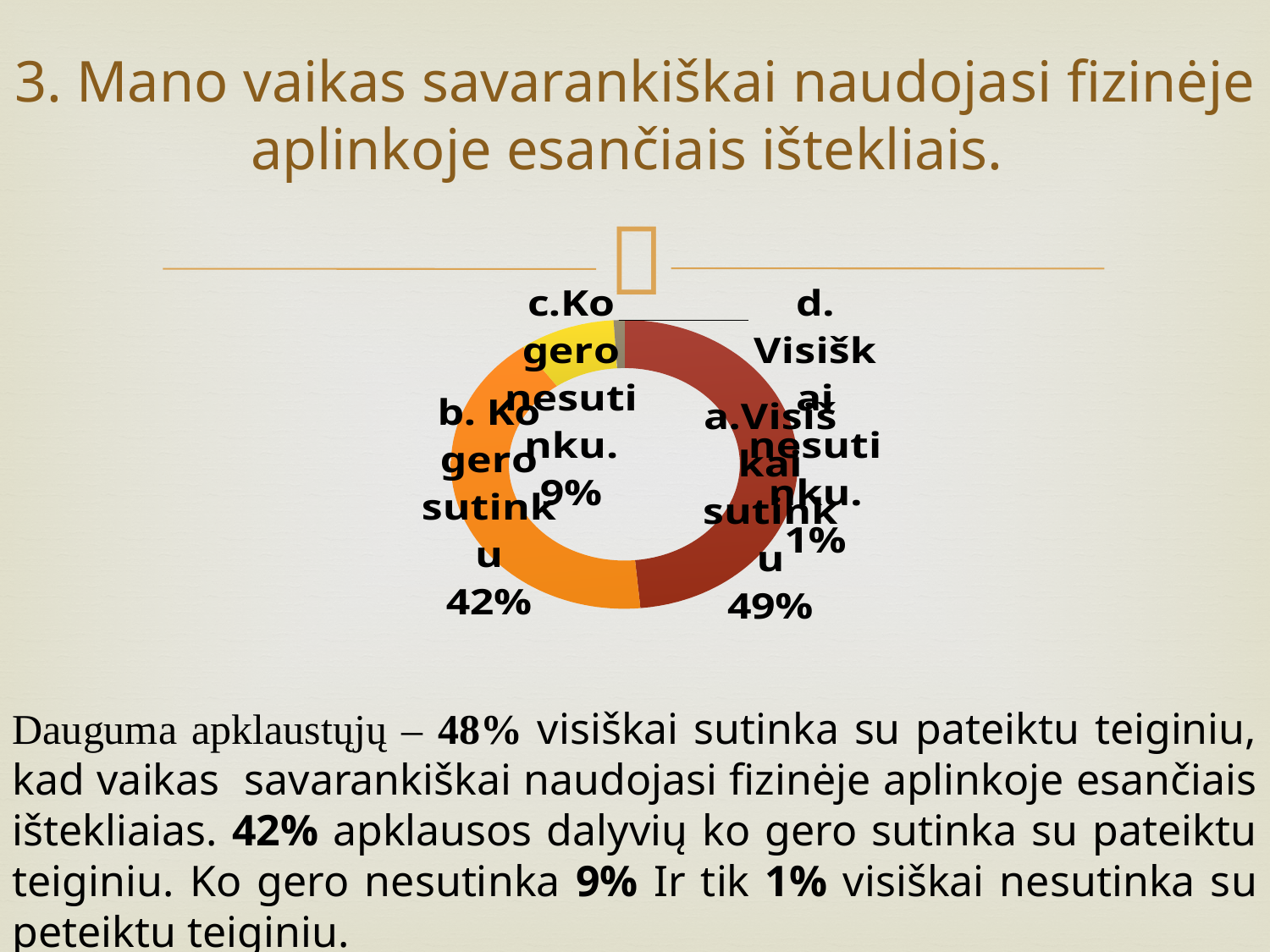
What is the combined share of "c. Ko gero nesutinku" and "d. Visiškai nesutinku"? 10% Which category has the smallest share of the doughnut chart? d. Visiškai nesutinku What colour is the slice for "b. Ko gero sutinku"? Orange How many slices does the doughnut chart have? 4 Which category has the largest share of the doughnut chart? a. Visiškai sutinku What is the difference in percentage points between "a. Visiškai sutinku" and "b. Ko gero sutinku"? 7 What percentage is shown for "a. Visiškai sutinku"? 49% What percentage is shown for "d. Visiškai nesutinku"? 1% Which is larger, the share for "c. Ko gero nesutinku" or for "d. Visiškai nesutinku"? c. Ko gero nesutinku What kind of chart is shown on the slide? Doughnut chart What percentage is shown for "c. Ko gero nesutinku"? 9% What percentage is shown for "b. Ko gero sutinku"? 42%